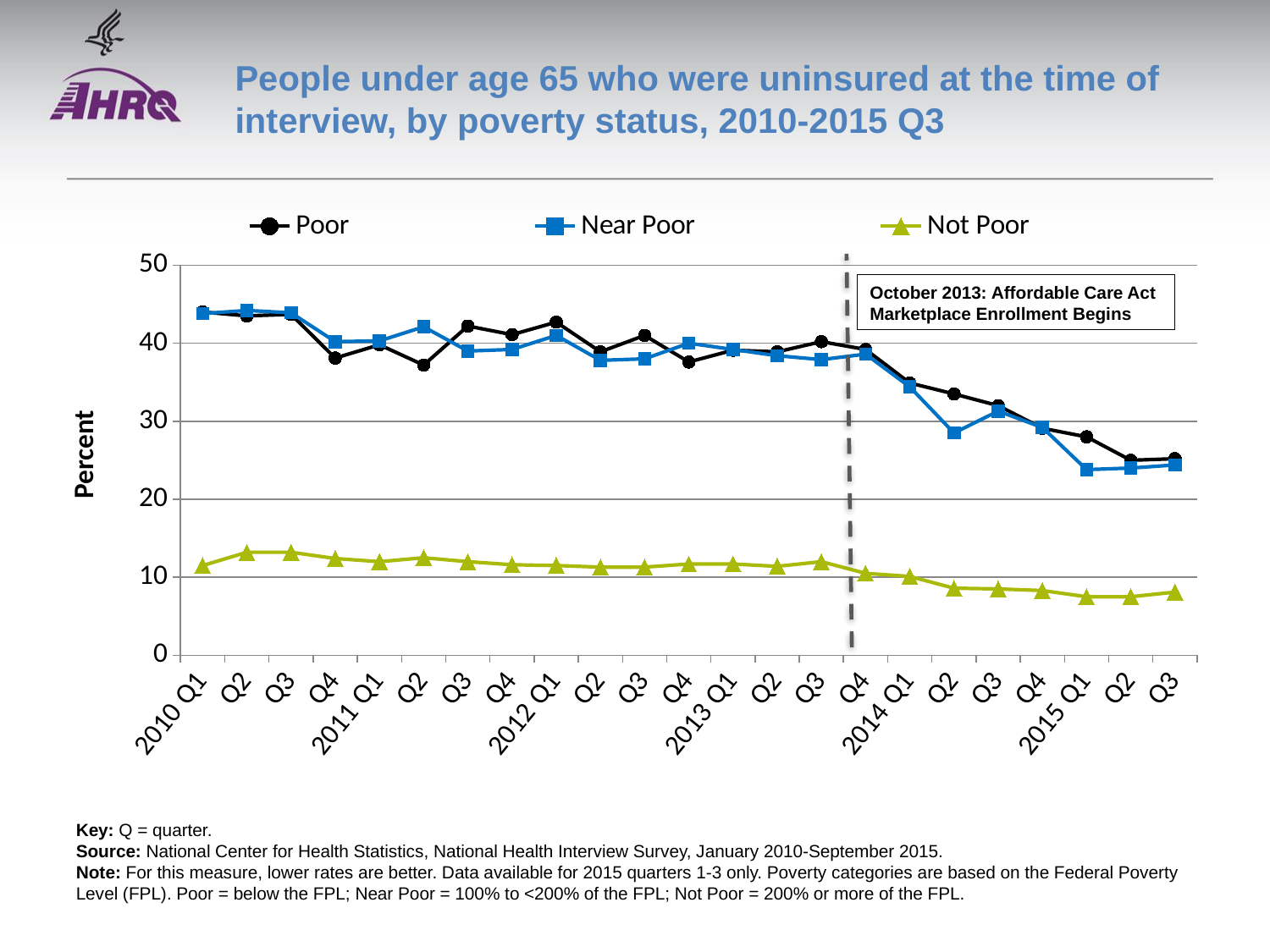
What kind of chart is shown on the slide? Line chart Which series has the lowest values across the entire period? Not Poor In 2014 Q2, which is larger, the value for Poor or the value for Near Poor? Poor How many series does the legend list? 3 Is the value for Not Poor in 2015 Q3 greater or less than 10? less Is the value for Poor in 2015 Q3 greater or less than 30? less Is the value for Poor in 2010 Q1 greater or less than 40? greater How many quarterly data points are plotted along the x axis for each series? 23 What event does the dashed vertical line mark, according to the annotation box? October 2013: Affordable Care Act Marketplace Enrollment Begins Do the values for Poor rise or fall from 2013 Q4 to 2015 Q3? Fall What is the label on the y axis? Percent